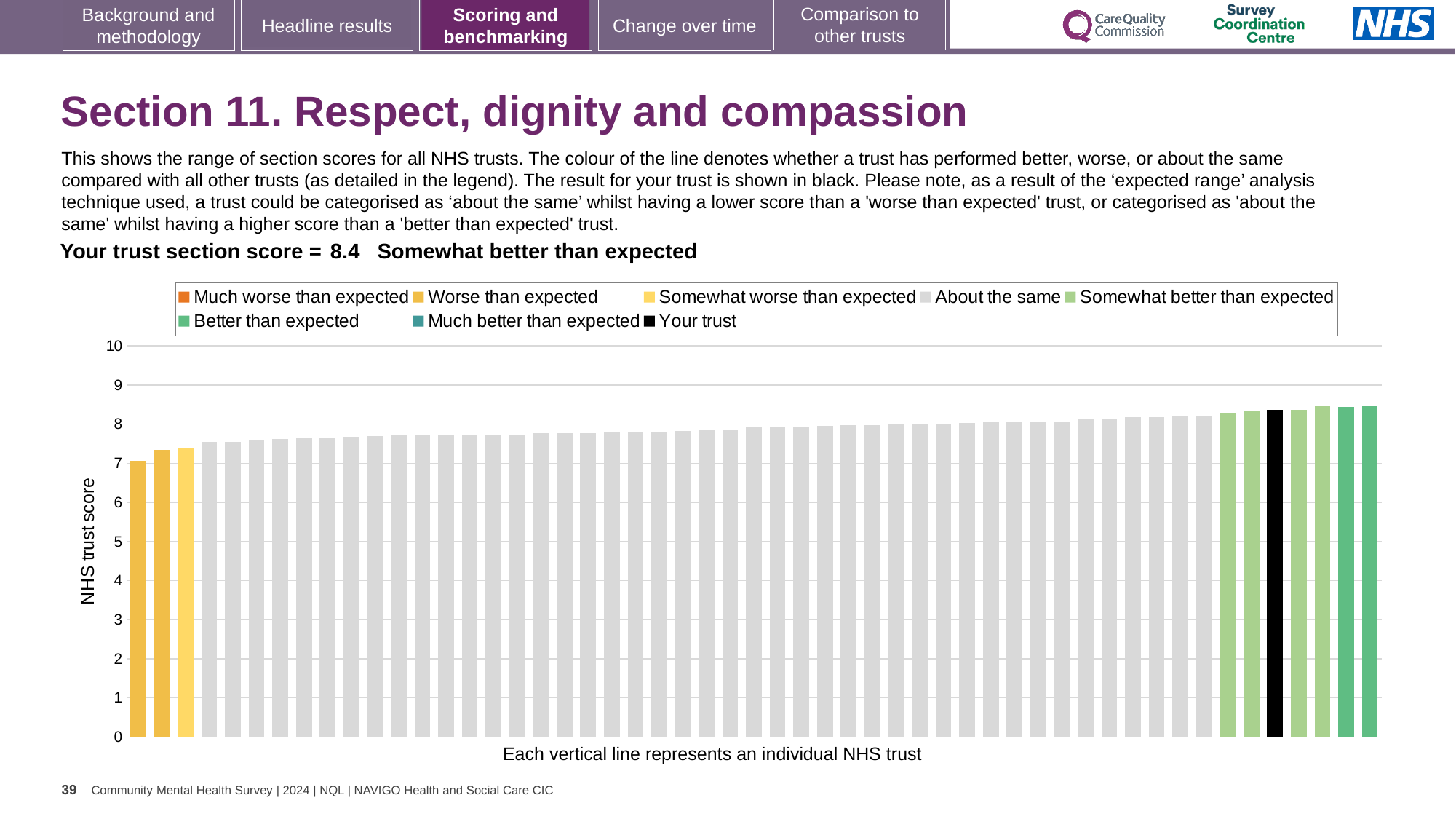
Which is taller: the black 'Your trust' bar or the leftmost bar? the black 'Your trust' bar How many entries does the chart legend list? 8 What is the section score for your trust shown on the slide? 8.4 Is the value of the lowest bar in the chart greater or less than 8? less Which legend category does your trust fall into for this section? Somewhat better than expected Is the value of the black 'Your trust' bar greater or less than 8? greater How many bars are coloured in the yellow 'worse than expected' shades at the left of the chart? 3 Is the value of the lowest bar in the chart greater or less than 6? greater What colour is used for the 'Your trust' bar in the chart? black What kind of chart is shown on the slide? bar chart What is the label on the vertical axis of the chart? NHS trust score